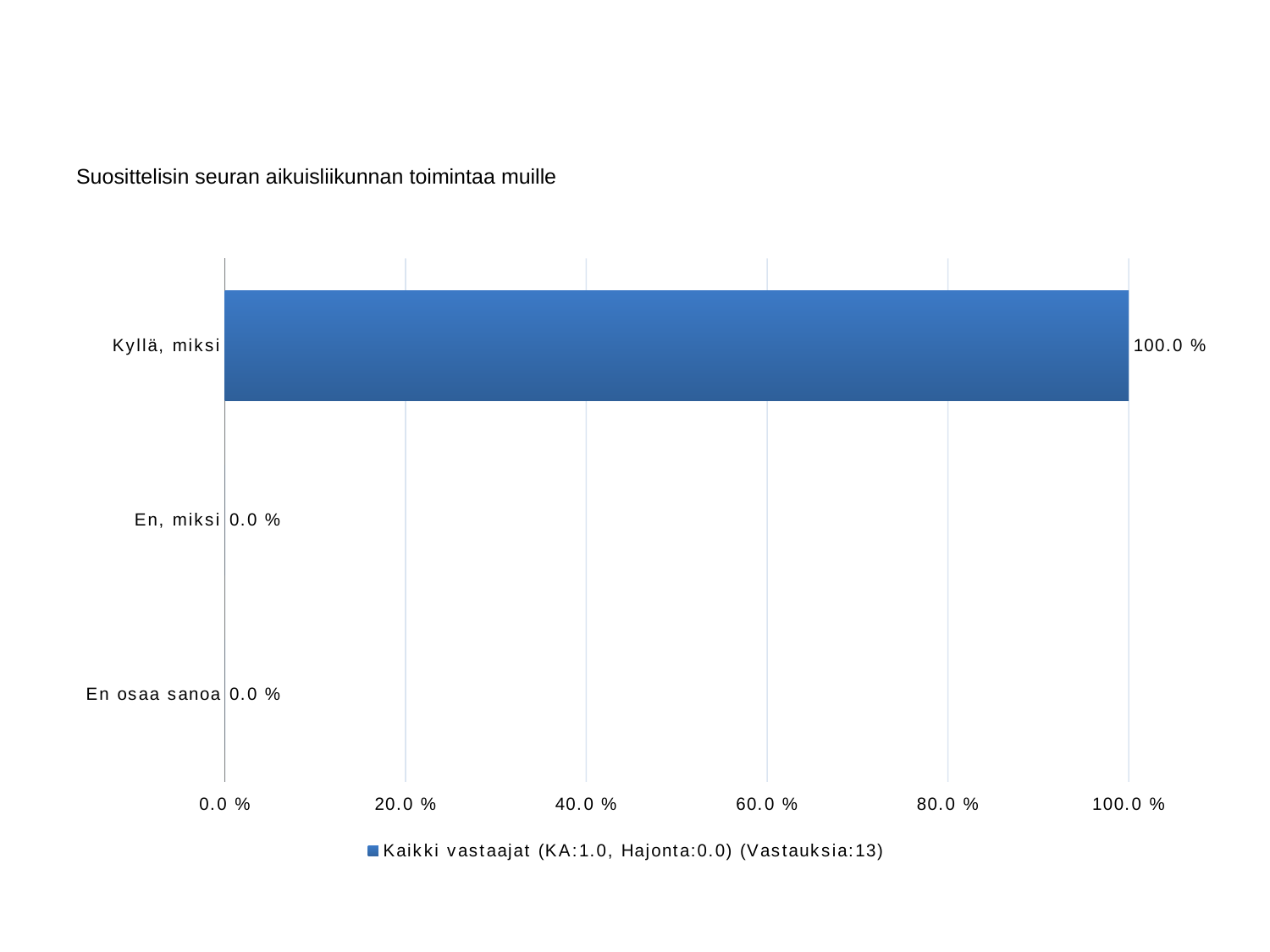
What is the difference between the values for "Kyllä, miksi" and "En, miksi"? 100.0 % What is the value for "Kyllä, miksi"? 100.0 % What is the title of the chart? Suosittelisin seuran aikuisliikunnan toimintaa muille How many responses (Vastauksia) does the legend entry report? 13 How many categories are shown on the chart? 3 What is the value for "En osaa sanoa"? 0.0 % Which category has the highest value? Kyllä, miksi Which is larger, the value for "Kyllä, miksi" or the value for "En osaa sanoa"? Kyllä, miksi Is the value for "Kyllä, miksi" greater or less than 80.0 %? greater How many series does the legend list? 1 What is the value for "En, miksi"? 0.0 % What kind of chart is shown on the slide? bar chart